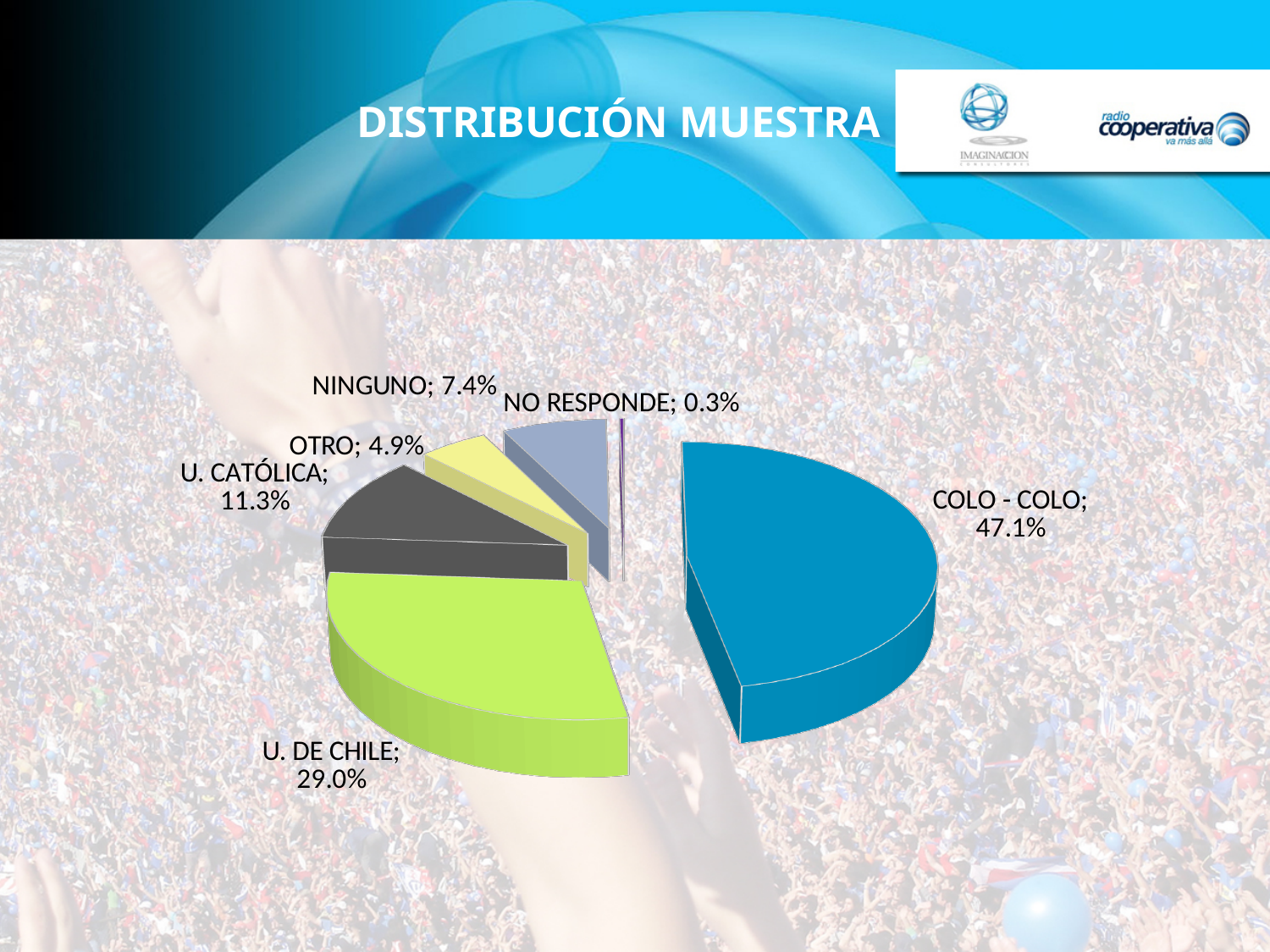
What percentage is shown for NINGUNO? 7.4% Which category has the smallest share of the pie? NO RESPONDE What percentage is shown for U. CATÓLICA? 11.3% How many slices does the pie chart have? 6 What percentage is shown for COLO - COLO? 47.1% What is the title of the chart? DISTRIBUCIÓN MUESTRA What type of chart is shown on the slide? Pie chart What percentage is shown for U. DE CHILE? 29.0% Which is larger, the share for OTRO or the share for NINGUNO? NINGUNO Which category has the largest share of the pie? COLO - COLO What is the difference between the COLO - COLO and U. DE CHILE percentages? 18.1% What percentage is shown for NO RESPONDE? 0.3%